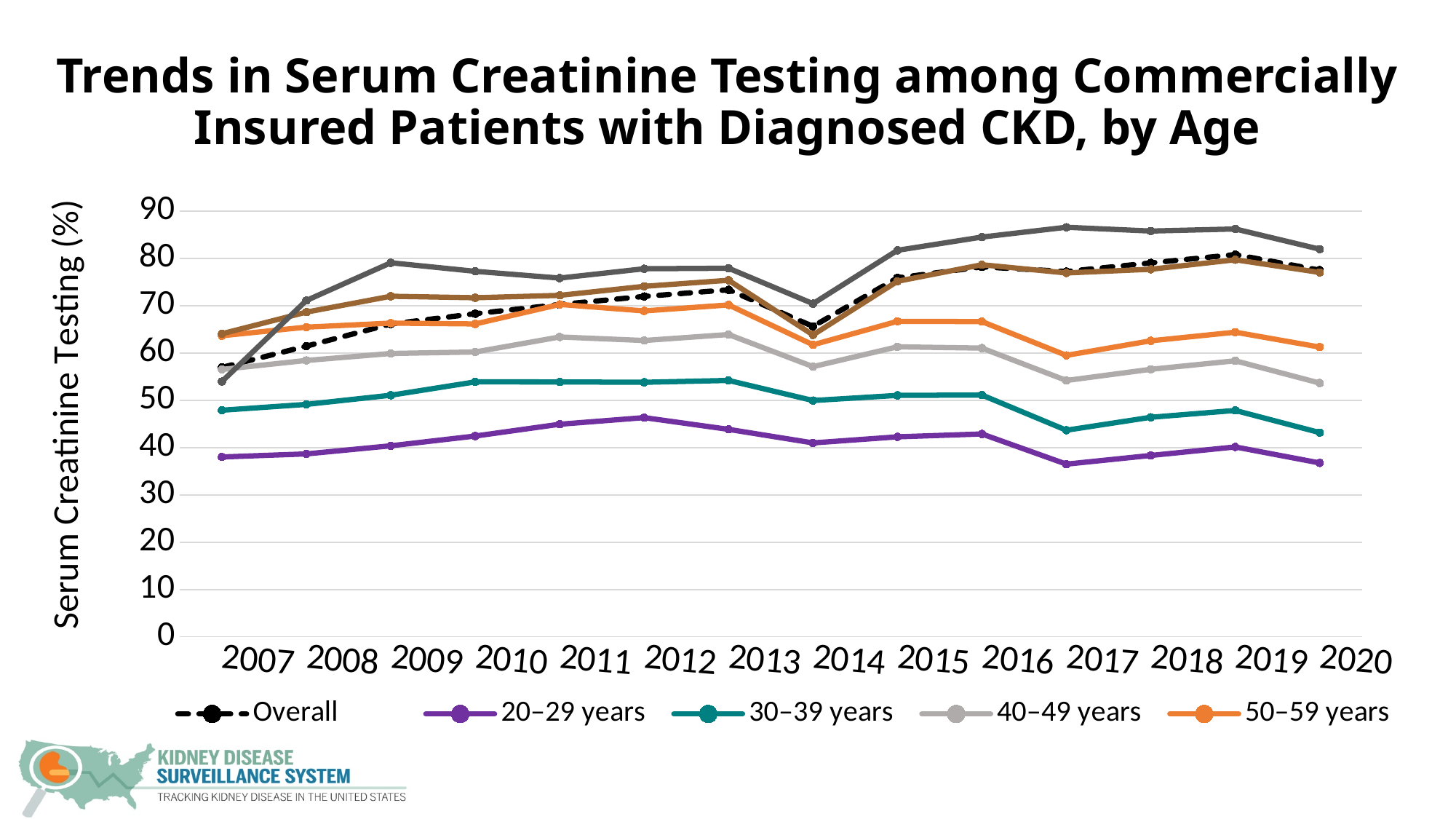
Among the series named in the legend, which has the lowest value in 2020? 20–29 years How many years are shown along the x axis? 14 Is the value for 40–49 years in 2019 greater or less than 50? greater How many series does the legend list? 5 Is the value for 30–39 years in 2020 greater or less than 50? less Is the value for 50–59 years in 2014 greater or less than 70? less In 2012, which is larger: the value for 20–29 years or the value for 30–39 years? 30–39 years Does the Overall line rise or fall from 2013 to 2014? fall What is the label of the y axis? Serum Creatinine Testing (%) What kind of chart is shown on the slide? line chart